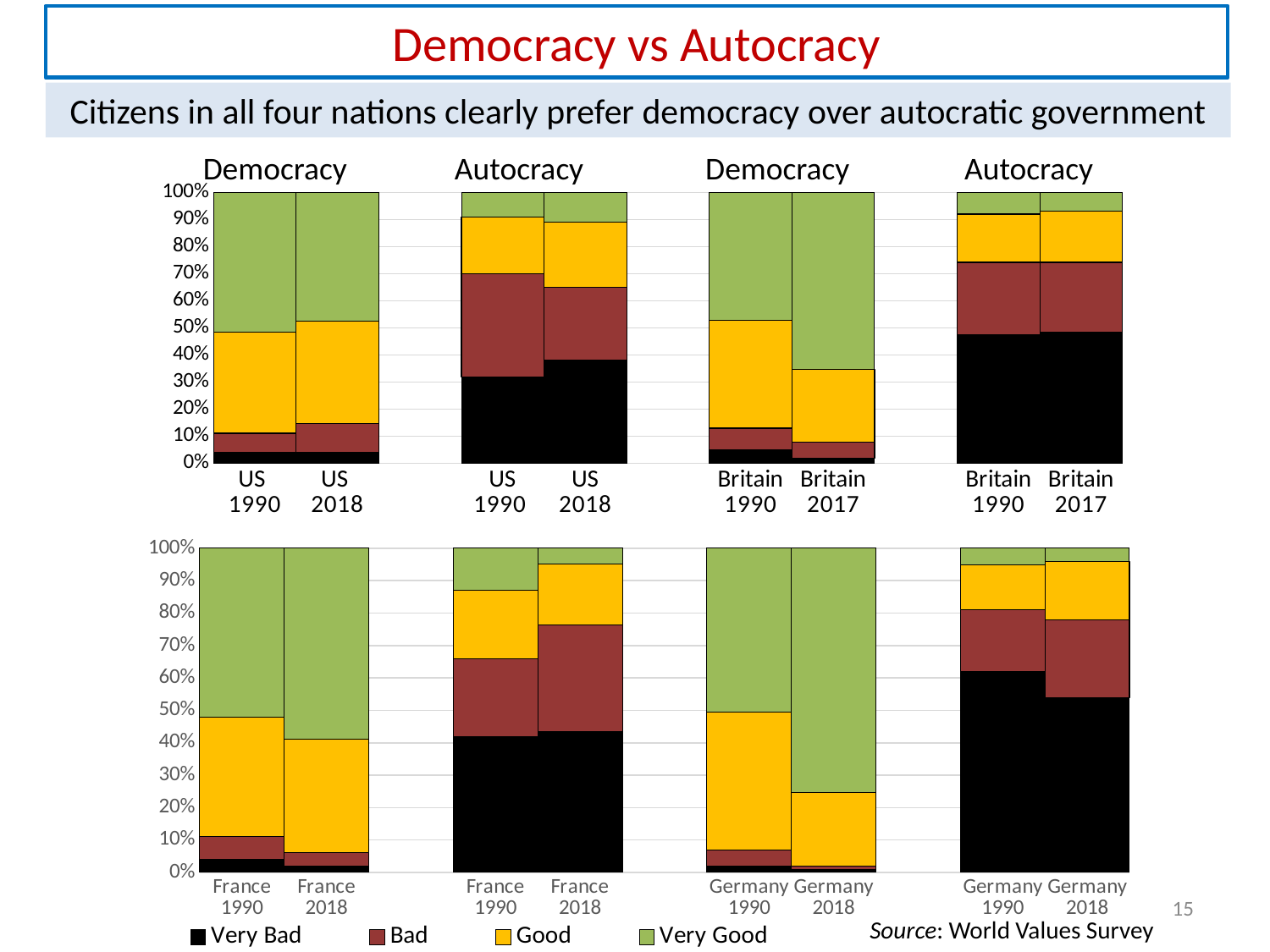
In the top chart, is the Very Bad share for US 2018 under Autocracy greater or less than 30%? greater In the top chart, which bar has the largest Very Good segment? Britain 2017 (Democracy) In the bottom chart, which bar has the largest Very Bad segment? Germany 1990 (Autocracy) What kind of chart is the top chart on the slide? Stacked bar chart In the bottom chart, is the Very Bad share under Autocracy larger for Germany 1990 or Germany 2018? Germany 1990 In the bottom chart, is the Very Bad share for France 1990 under Autocracy greater or less than 30%? greater How many bars are plotted in the bottom chart (France and Germany)? 8 Which colour represents the Very Good category in the legend? Green In the top chart, is the Very Bad share for Britain 1990 under Autocracy greater or less than 40%? greater How many series does the legend at the bottom of the slide list? 4 In the top chart, does the Very Good share for Britain under Democracy rise or fall from 1990 to 2017? Rise